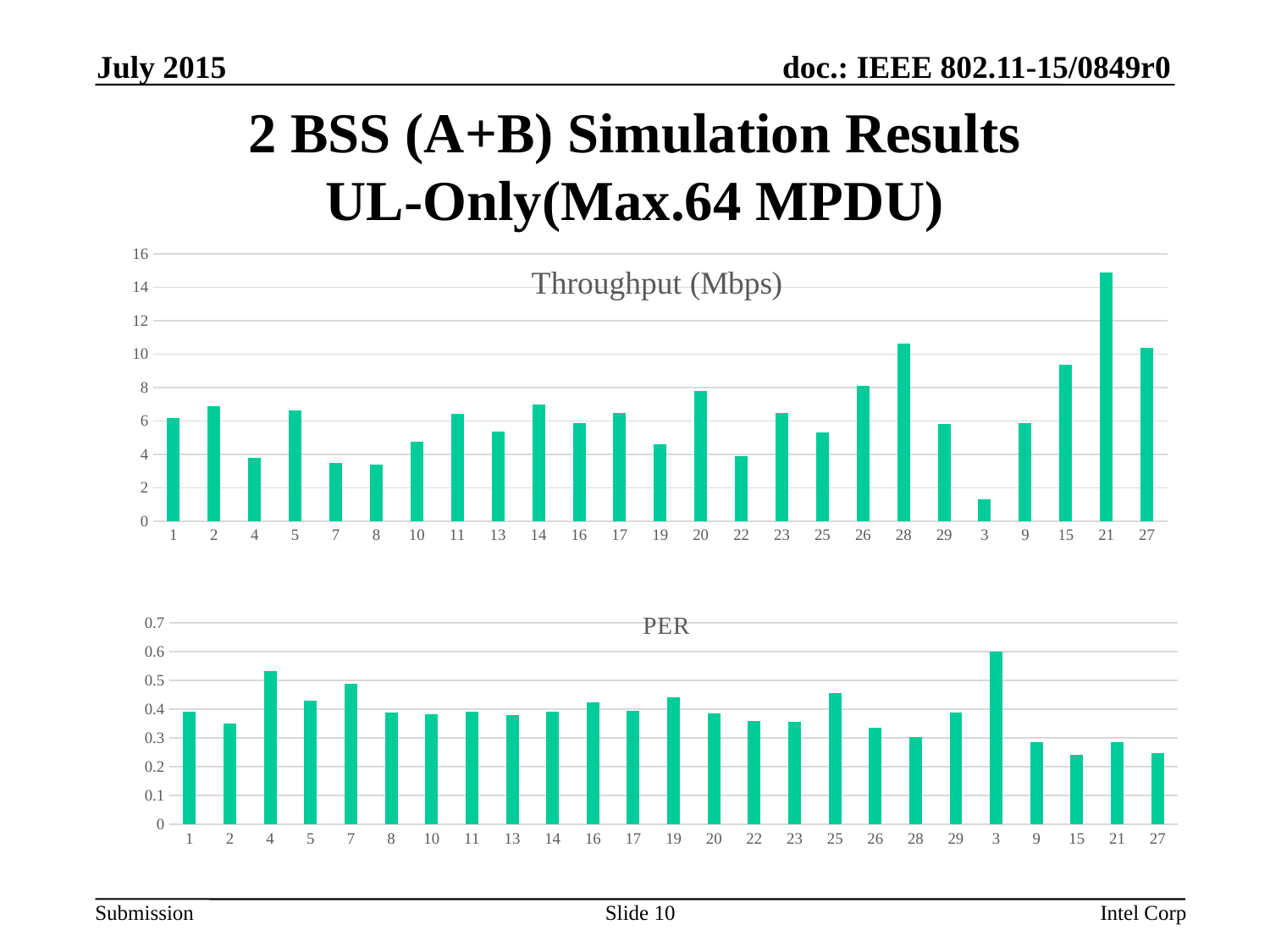
How many categories are shown on the x axis of the Throughput (Mbps) chart? 25 In the PER chart, is the value for category 15 greater or less than 0.3? less In the Throughput (Mbps) chart, which category has the lowest throughput? 3 In the Throughput (Mbps) chart, is the value for category 3 greater or less than 2? less In the PER chart, which category has the highest PER? 3 What kind of chart is the PER chart? bar chart In the Throughput (Mbps) chart, which has the larger value, category 21 or category 27? 21 In the Throughput (Mbps) chart, which category has the highest throughput? 21 In the PER chart, is the value for category 3 greater or less than 0.5? greater In the PER chart, which has the larger value, category 4 or category 2? 4 In the PER chart, which category has the lowest PER? 15